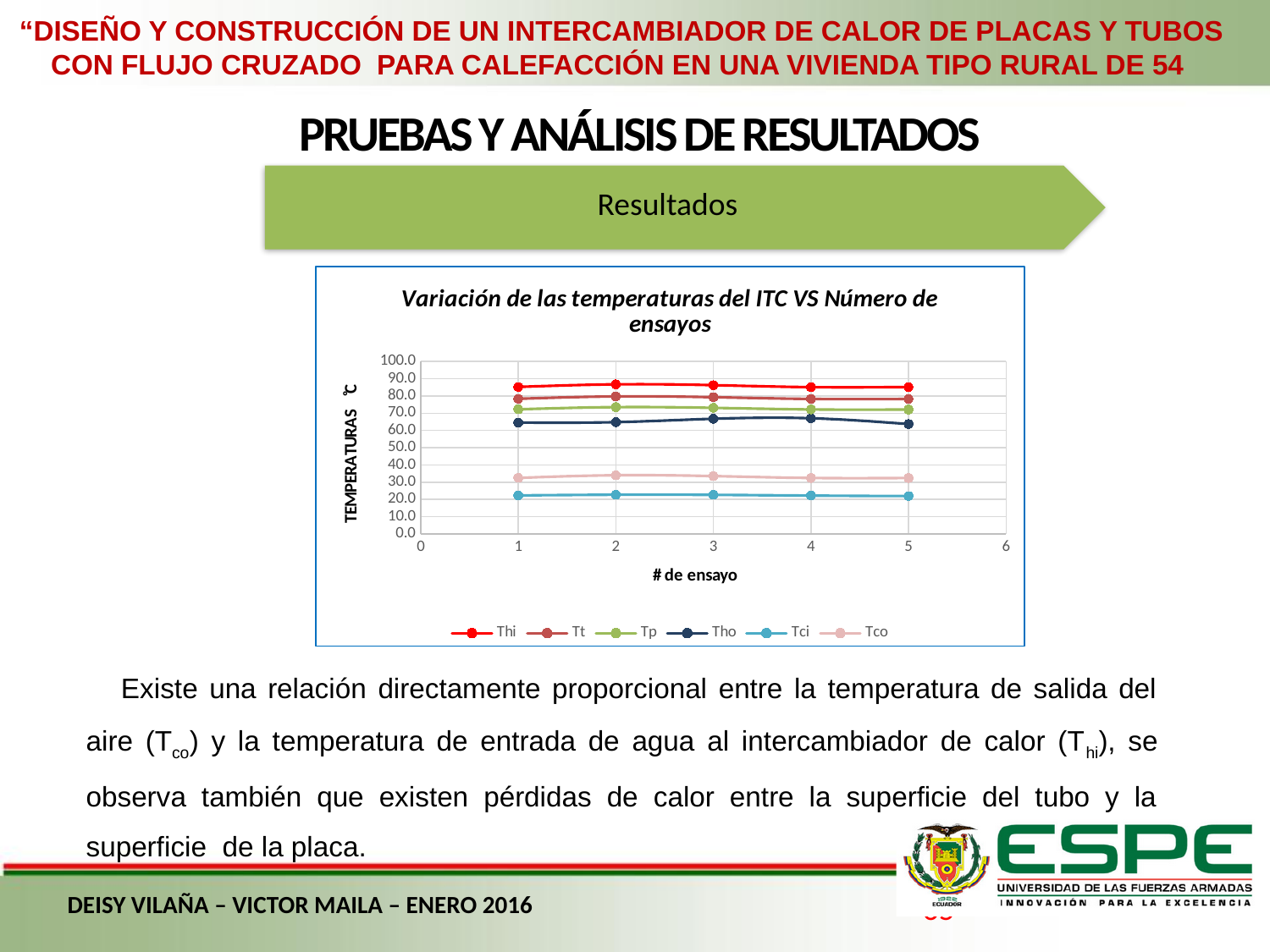
Is the value for Tci at ensayo 3 greater or less than 30? less Which series has the highest temperatures across all ensayos? Thi Which series has the lowest temperatures across all ensayos? Tci Is the value for Tco at ensayo 4 greater or less than 40? less How many series does the legend list? 6 What kind of chart is shown on the slide? line chart What is the title of the chart? Variación de las temperaturas del ITC VS Número de ensayos Is the value for Tho at ensayo 1 greater or less than 60? greater At ensayo 3, which is larger, the value for Tt or the value for Tp? Tt What is the label of the x axis of the chart? # de ensayo How many ensayo (test) points are plotted for each series? 5